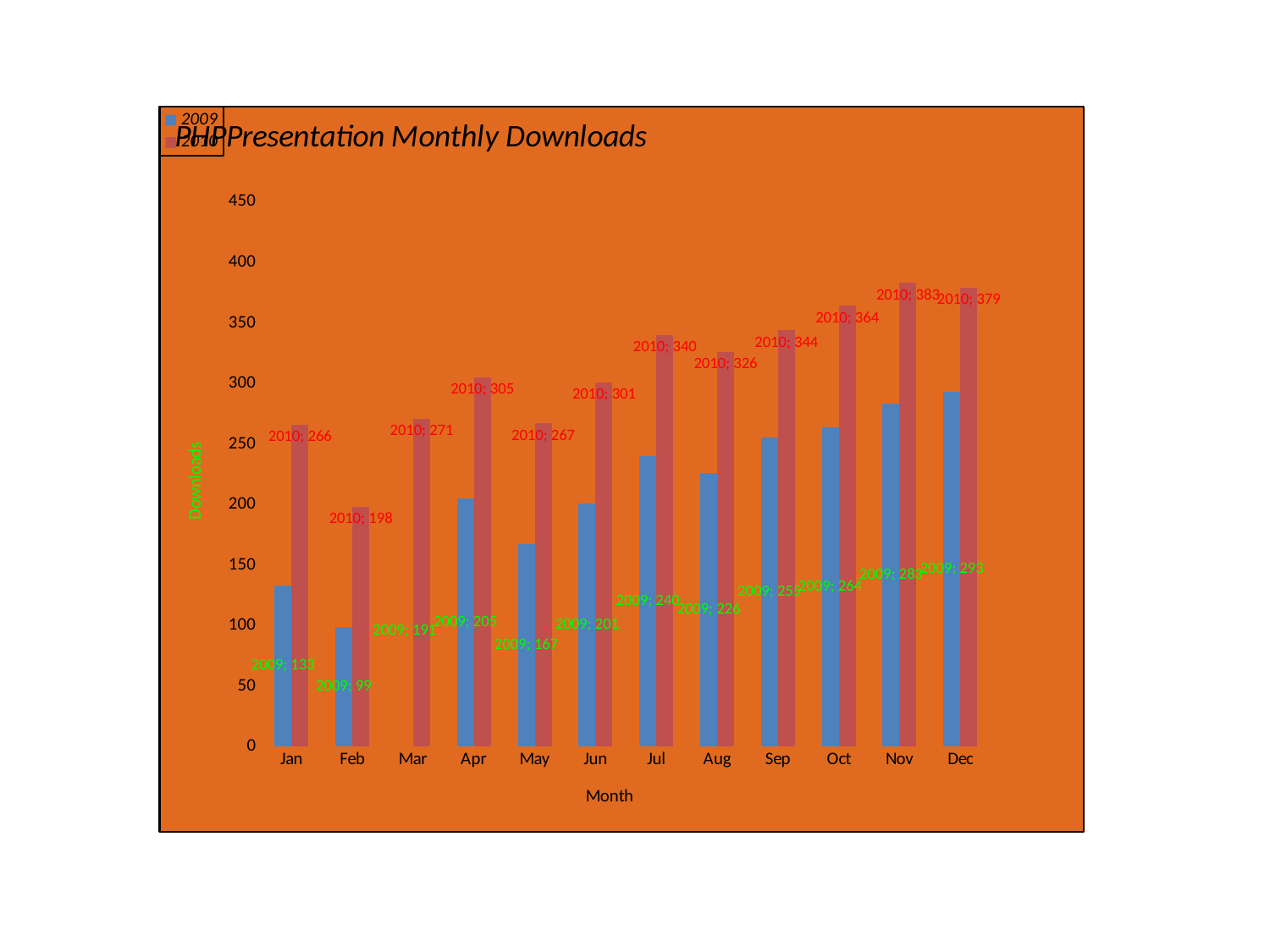
What is the value for 2010 in Jul? 340 How many series does the legend list? 2 How many months are shown on the x axis? 12 Which month has the lowest value for the 2009 series? Feb Which month has the highest value for the 2010 series? Nov What is the value for 2009 in Dec? 293 What is the value for 2009 in Feb? 99 What is the difference between the 2010 and 2009 values in Jul? 100 What kind of chart is shown on the slide? bar chart Which is larger, the 2010 value in Nov or the 2010 value in Dec? Nov What is the value for 2010 in Nov? 383 Is the value for 2009 in Oct greater or less than 250? greater